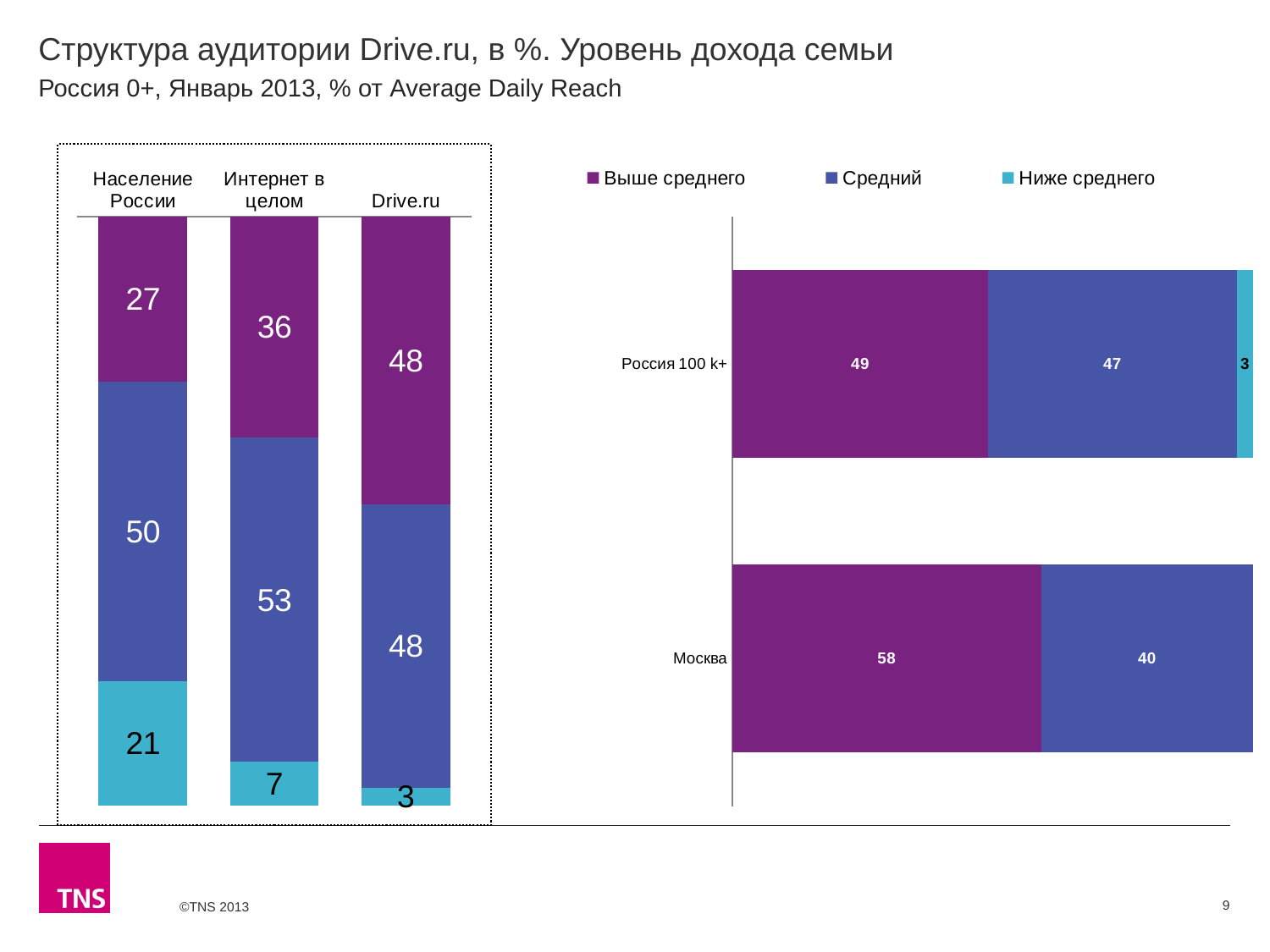
How many series does the legend list? 3 In the left chart, what is the value of the 'Ниже среднего' segment for 'Население России'? 21 In the right chart, what is the value of the 'Средний' segment for 'Россия 100 k+'? 47 In the left chart, which category has the lowest 'Ниже среднего' value? Drive.ru In the left chart, what is the value of the 'Средний' segment for 'Интернет в целом'? 53 In the left chart, what is the value of the 'Выше среднего' segment for Drive.ru? 48 What kind of chart is the right chart? Stacked bar chart In the right chart, what is the value of the 'Выше среднего' segment for Москва? 58 In the right chart, which is larger: the 'Выше среднего' value for Москва or for 'Россия 100 k+'? Москва In the left chart, what is the total of the stacked bar for 'Интернет в целом'? 96 In the left chart, which category has the highest 'Выше среднего' value? Drive.ru In the left chart, what is the difference between the 'Выше среднего' values for Drive.ru and 'Население России'? 21